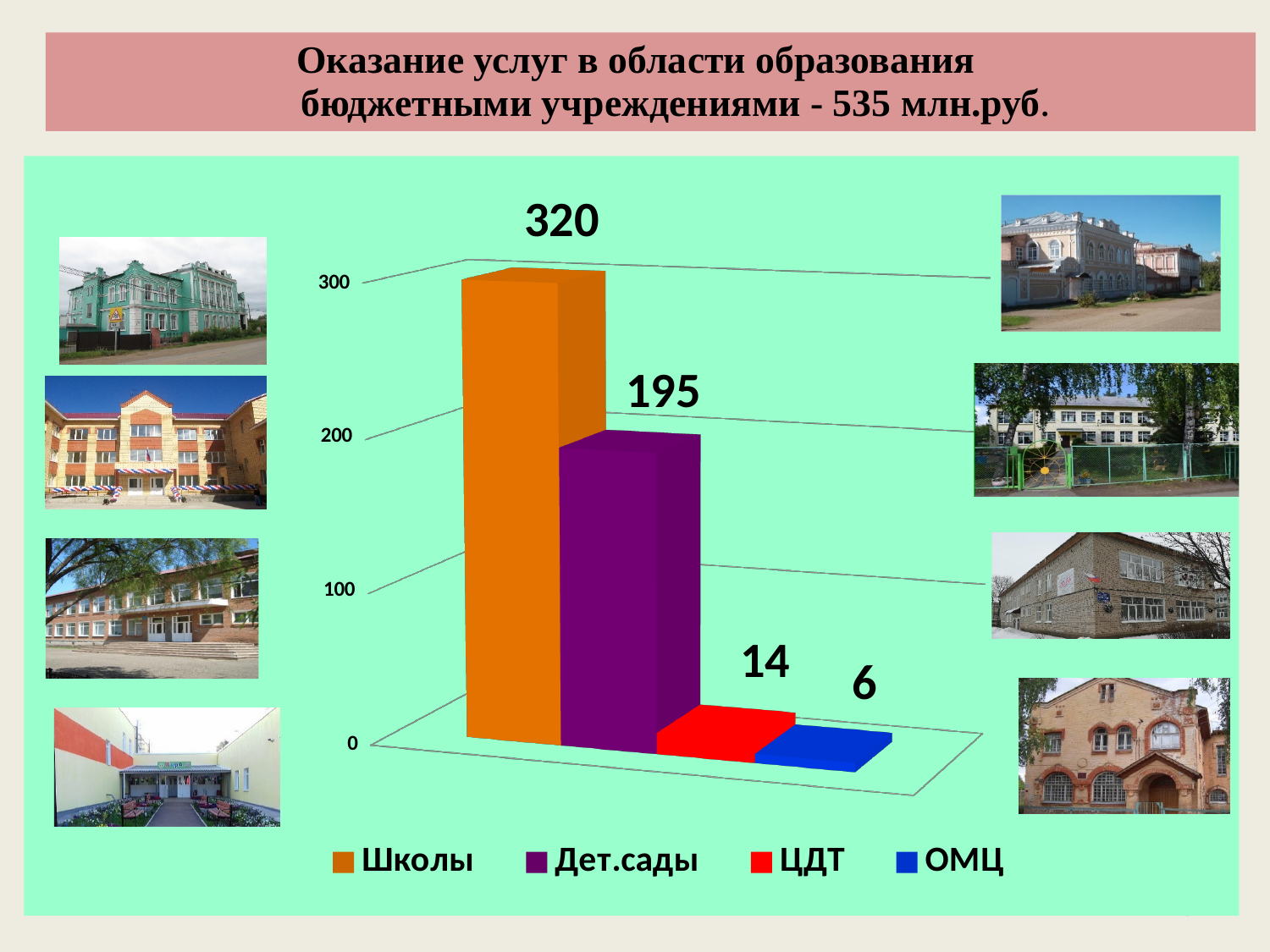
What is the difference between the values for Школы and Дет.сады? 125 Which category has the lowest value? ОМЦ What kind of chart is shown on the slide? bar chart What colour is the bar for Дет.сады? purple What is the value for ОМЦ? 6 Is the value for Дет.сады greater or less than 200? less What is the value for Школы? 320 What is the value for ЦДТ? 14 Which category has the highest value? Школы How many series does the legend list? 4 What is the value for Дет.сады? 195 Which is larger, the value for ЦДТ or the value for ОМЦ? ЦДТ